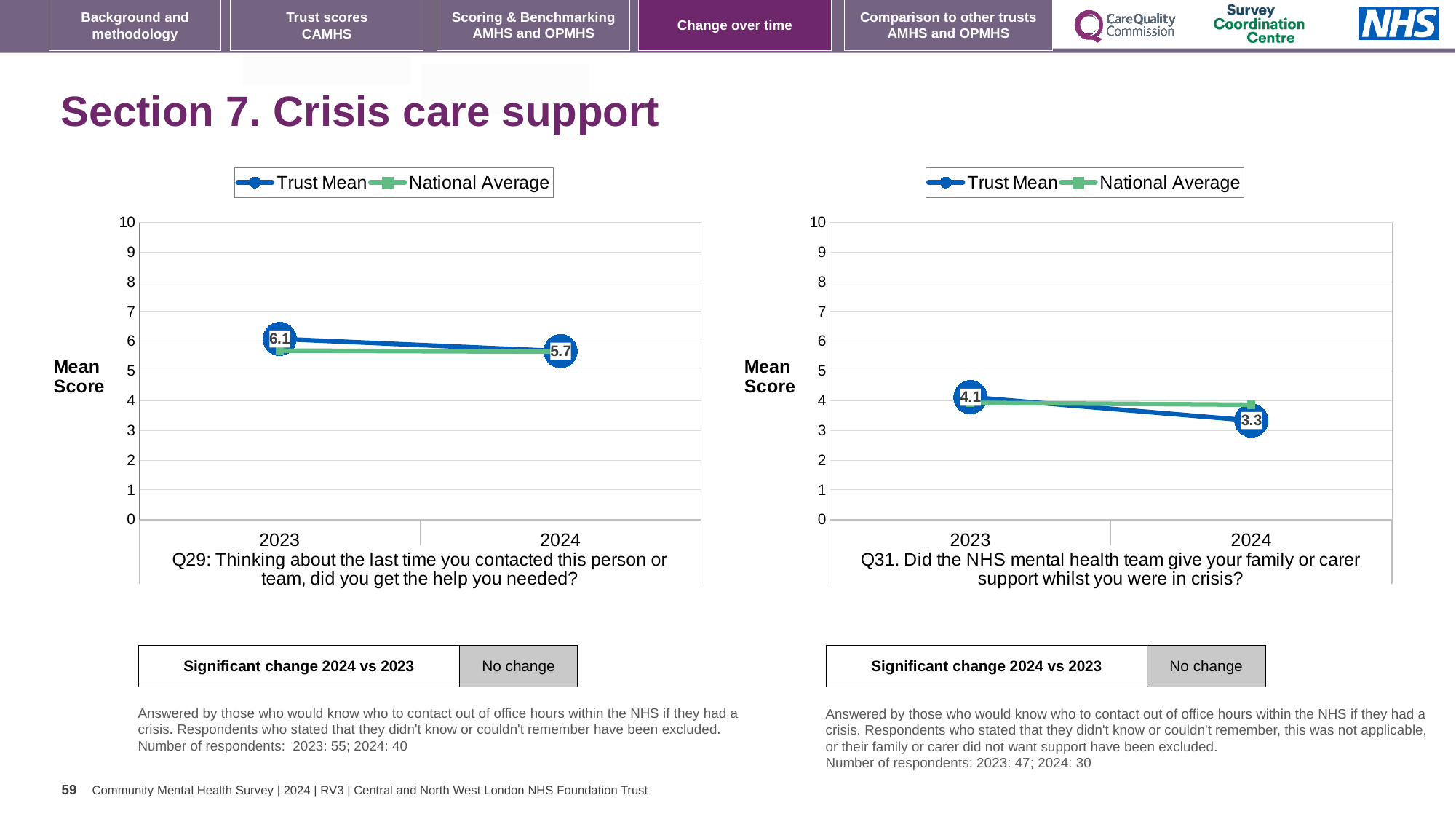
In the Q29 chart on the left, by how much did the Trust Mean fall from 2023 to 2024? 0.4 In the Q29 chart on the left, which year has the higher Trust Mean, 2023 or 2024? 2023 In the Q31 chart on the right, is the National Average for 2024 greater or less than 5? less In the Q31 chart on the right, what is the Trust Mean score for 2023? 4.1 What type of chart is the Q29 chart on the left? line chart In the Q29 chart on the left, what is the Trust Mean score for 2023? 6.1 In the Q29 chart on the left, what is the Trust Mean score for 2024? 5.7 In the Q31 chart on the right, what is the difference between the Trust Mean for 2023 and 2024? 0.8 In the Q31 chart on the right, does the Trust Mean rise or fall from 2023 to 2024? fall How many series does the legend of the Q31 chart on the right list? 2 In the Q31 chart on the right, what is the Trust Mean score for 2024? 3.3 In the Q29 chart on the left, is the National Average for 2023 greater or less than 5? greater